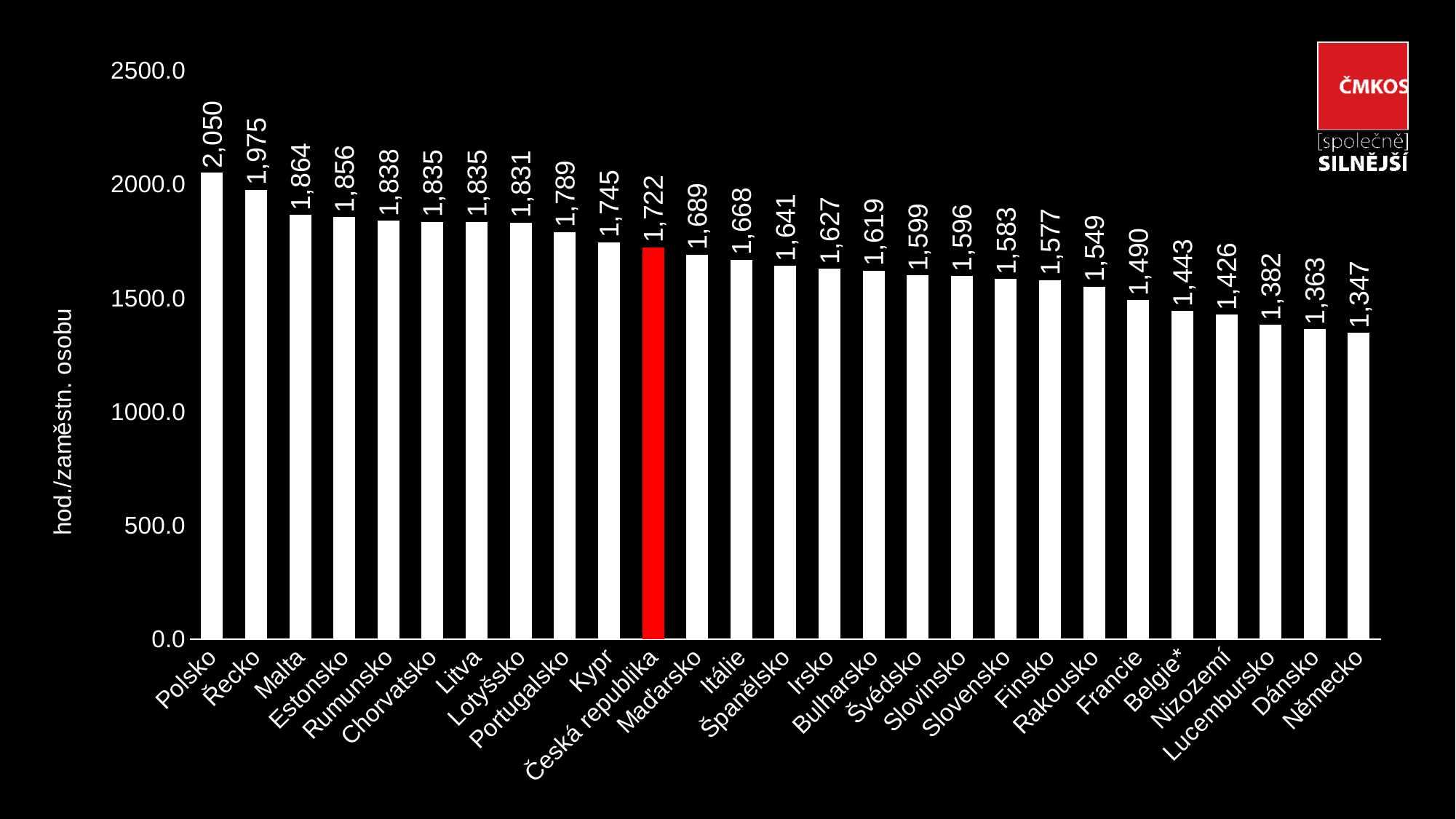
How many countries are shown on the chart? 27 What is the value for Česká republika? 1,722 Which has a larger value, Řecko or Malta? Řecko Which bar is highlighted in red? Česká republika Which country has the lowest value? Německo What is the difference between the values for Polsko and Německo? 703 What is the value for Německo? 1,347 What is the difference between the values for Česká republika and Slovensko? 139 Is the value for Francie greater or less than 1500.0? less Which country has the highest value? Polsko What is the value for Slovensko? 1,583 What kind of chart is this? bar chart